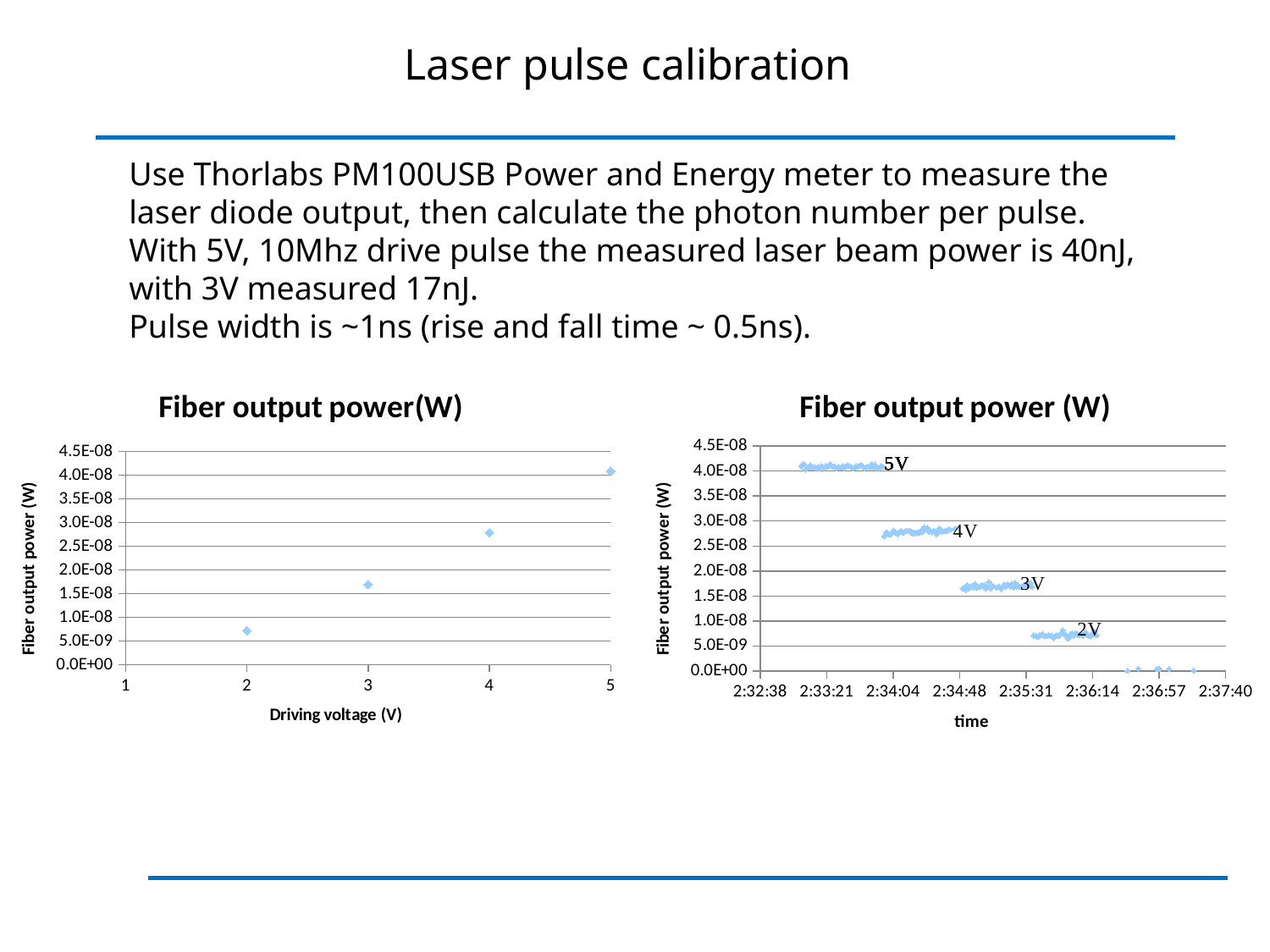
In the left chart "Fiber output power(W)", how many data points are plotted? 4 In the right chart "Fiber output power (W)", is the value of the 2V cluster greater or less than 1.0E-08? less In the left chart "Fiber output power(W)", which driving voltage has the lowest fiber output power? 2 In the left chart "Fiber output power(W)", which driving voltage has the highest fiber output power? 5 In the left chart "Fiber output power(W)", is the value at driving voltage 2 greater or less than 1.0E-08? less In the left chart "Fiber output power(W)", do the values rise or fall as driving voltage increases? rise In the right chart "Fiber output power (W)", do the values rise or fall as time increases? fall In the left chart "Fiber output power(W)", is the value at driving voltage 4 greater or less than 2.5E-08? greater In the left chart "Fiber output power(W)", what is the x-axis title? Driving voltage (V) What kind of chart is the left chart titled "Fiber output power(W)"? scatter chart